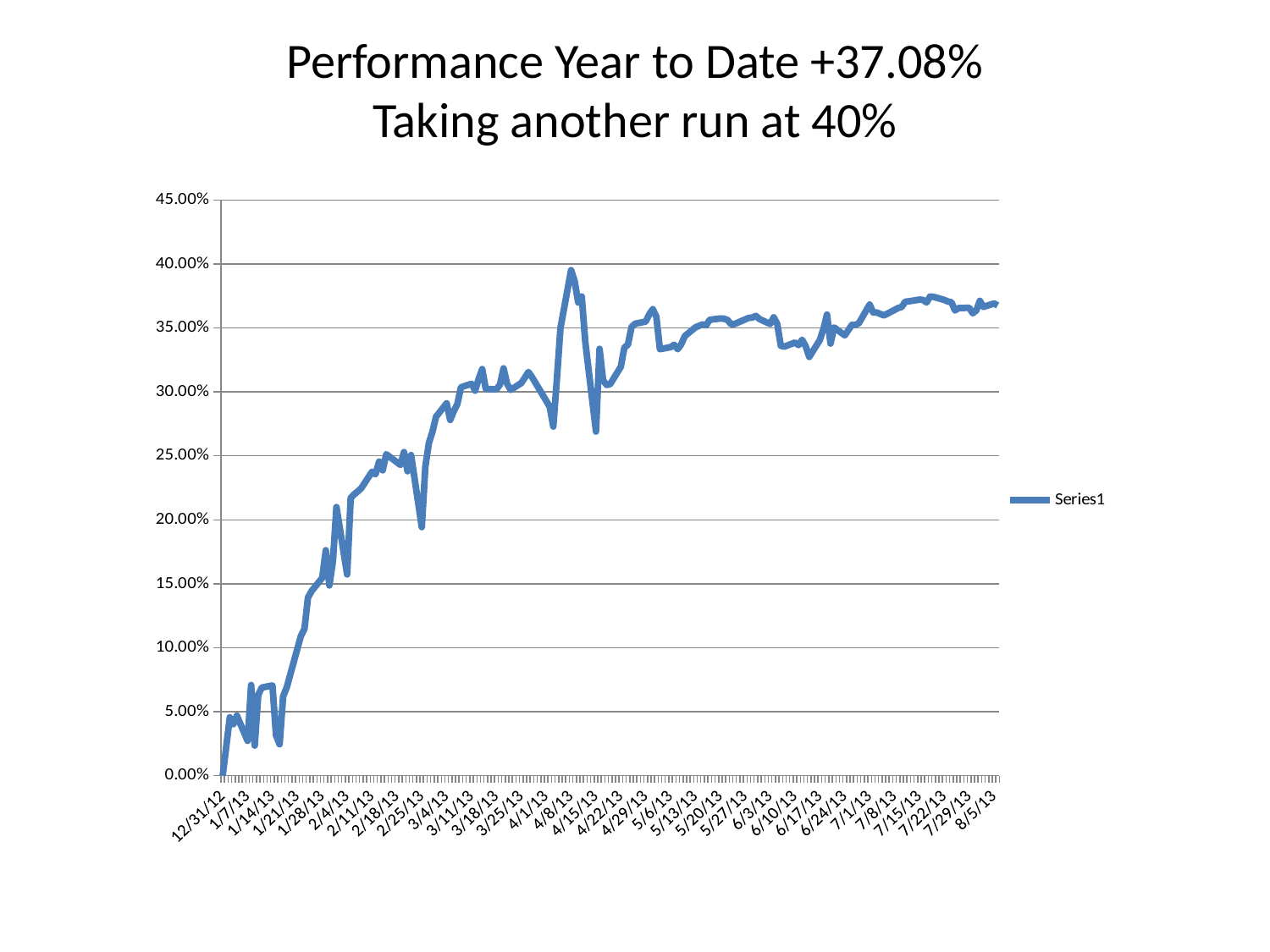
Overall, does the line rise or fall from 12/31/12 to 8/5/13? rise Is the value for 1/28/13 greater or less than 20%? less Is the value for 2/4/13 greater or less than 25%? less Is the value for 3/4/13 greater or less than 25%? greater How many series does the legend list? 1 What is the name of the series shown in the legend? Series1 What kind of chart is shown on the slide? line chart What is the first date label on the x axis? 12/31/12